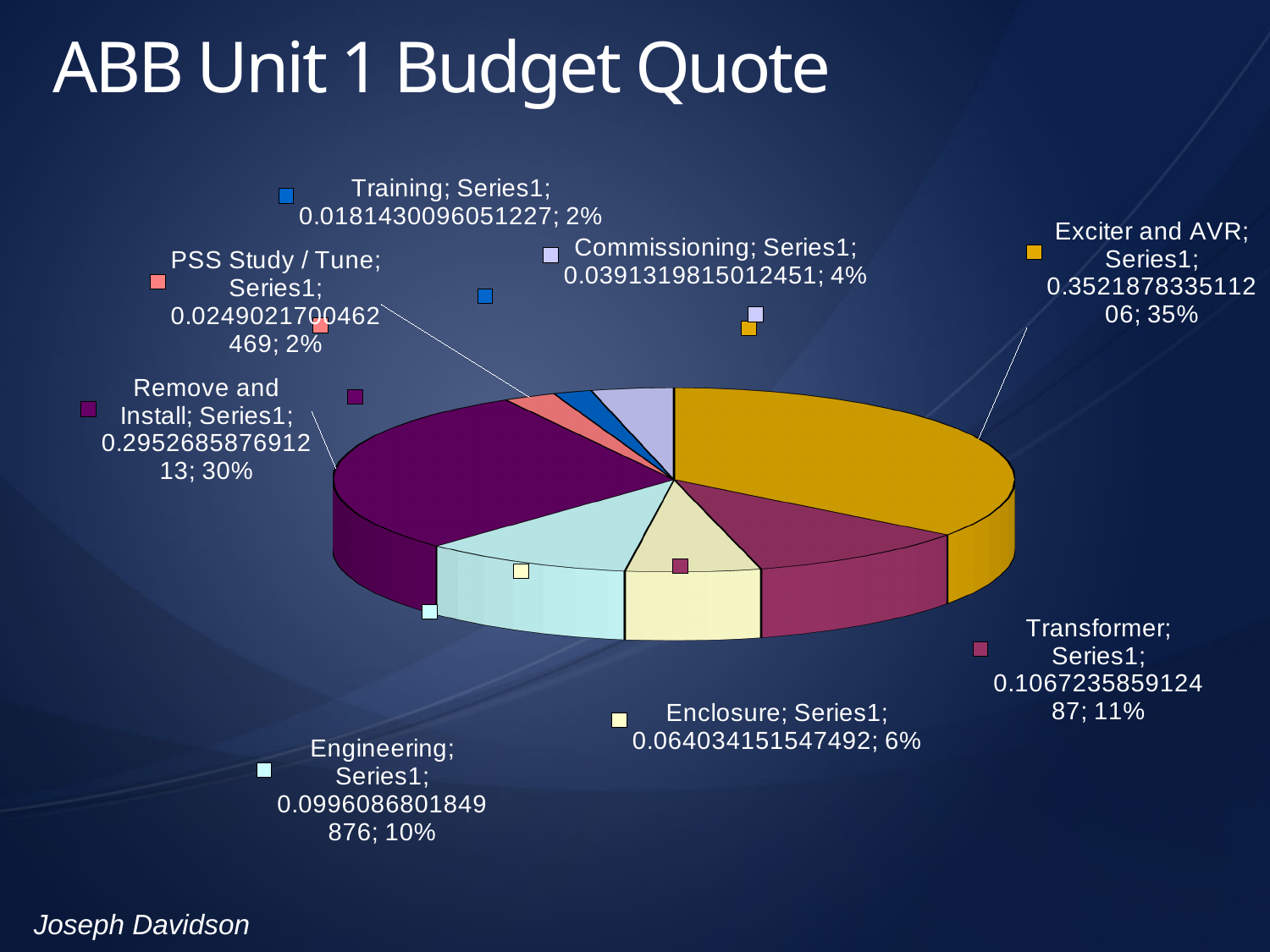
How many slices does the pie chart have? 8 What is the difference in percentage share between Exciter and AVR and Remove and Install? 5% What percentage share does the Remove and Install slice have? 30% What is the title of the chart? ABB Unit 1 Budget Quote What percentage share does the Commissioning slice have? 4% What percentage share does the Exciter and AVR slice have? 35% What is the value shown for Enclosure? 0.064034151547492 What kind of chart is shown on the slide? pie chart Which category has the largest slice of the pie? Exciter and AVR Which is larger, the Transformer slice or the Enclosure slice? Transformer